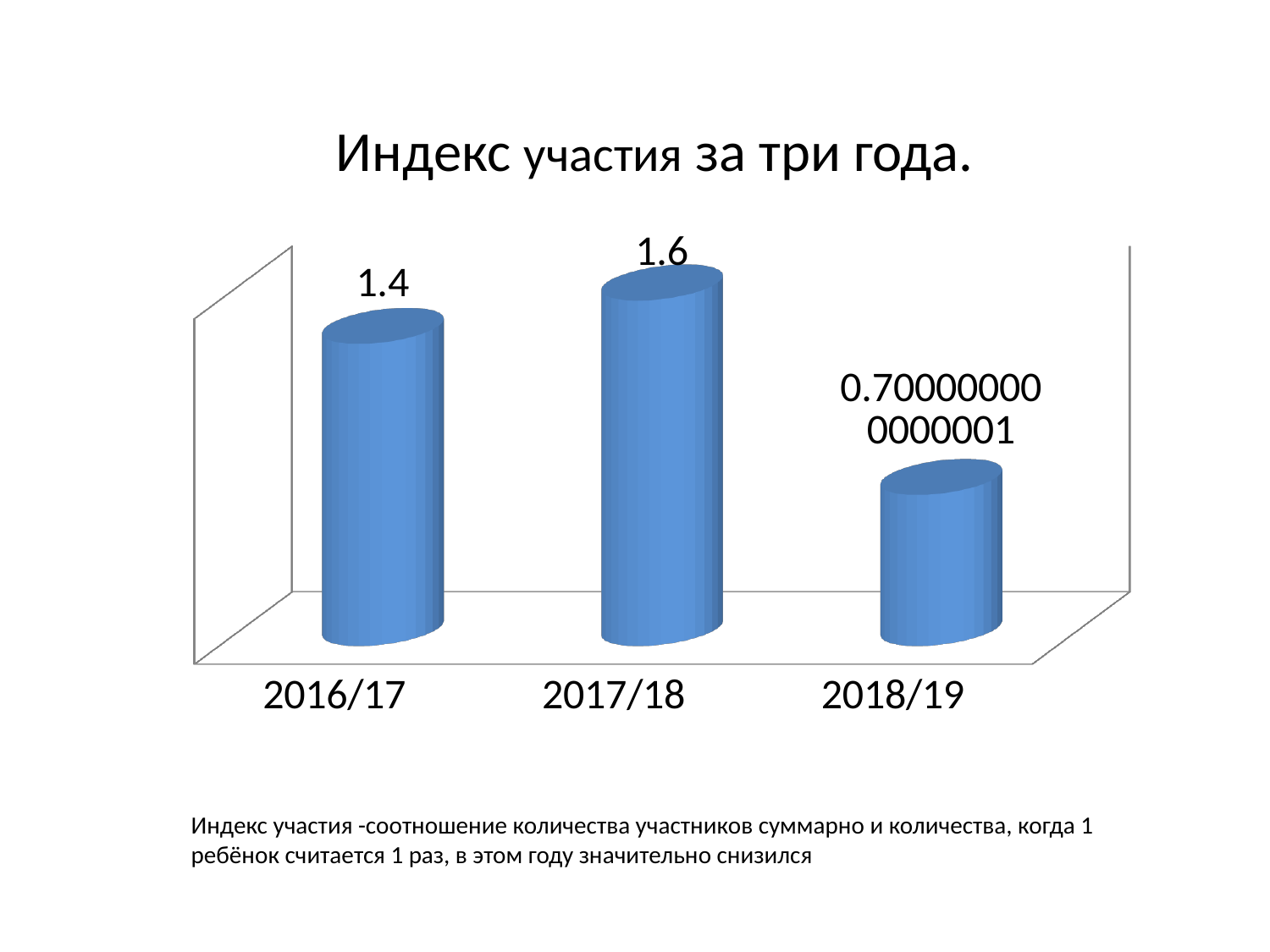
Which is larger, the value for 2016/17 or the value for 2018/19? 2016/17 Does the value rise or fall from 2017/18 to 2018/19? fall What is the value for 2016/17? 1.4 What colour are the bars in the chart? blue Which year has the highest participation index? 2017/18 What value is labelled on the bar for 2018/19? 0.700000000000001 What kind of chart is shown on the slide? bar chart How many years are shown on the chart? 3 What is the value for 2017/18? 1.6 What is the difference between the values for 2017/18 and 2016/17? 0.2 What is the title of the chart? Индекс участия за три года. Which year has the lowest participation index? 2018/19